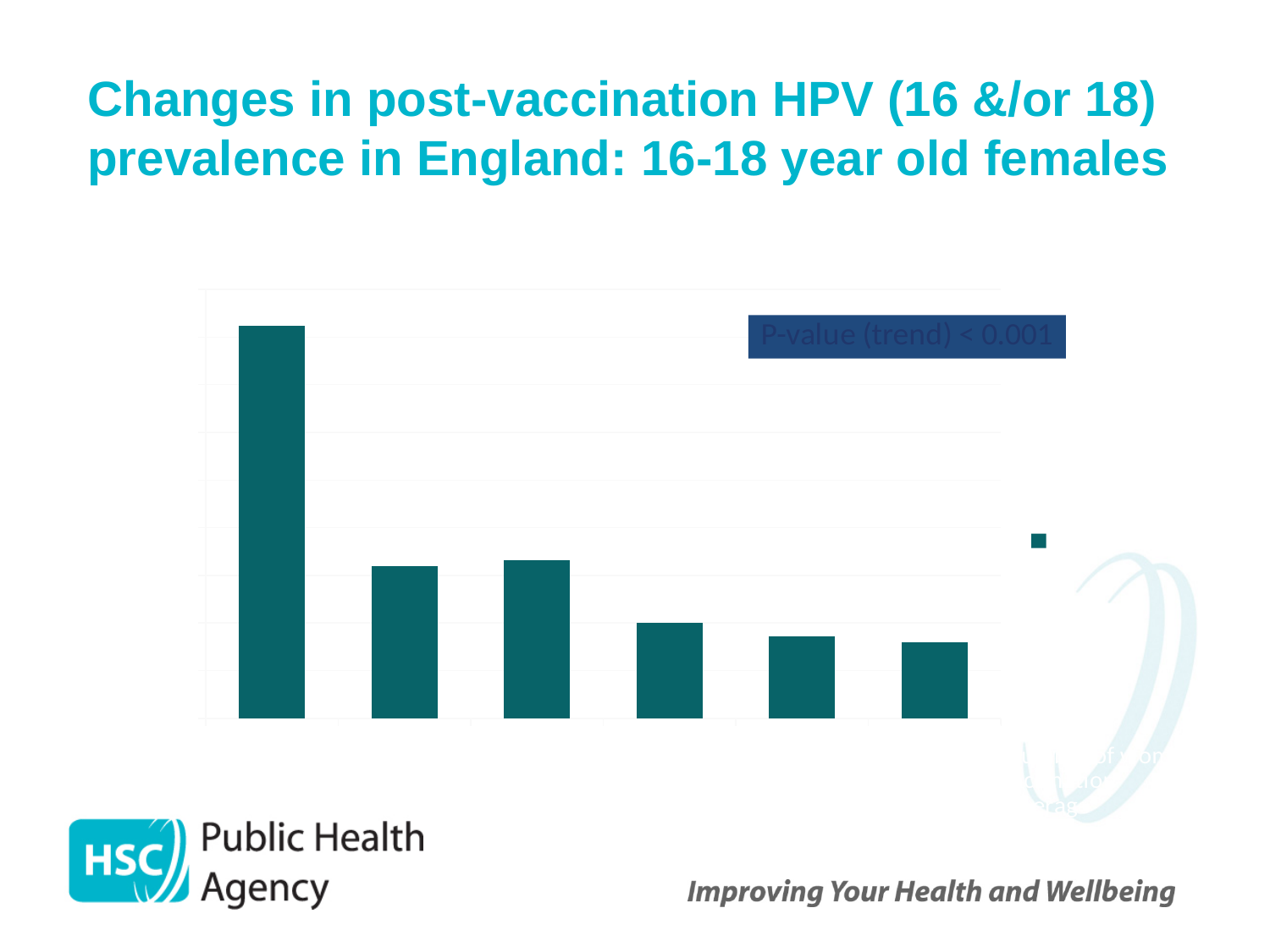
Is the fourth bar taller or shorter than the third bar? shorter Do the bar heights generally rise or fall from left to right across the chart? fall Is the first (leftmost) bar taller or shorter than the second bar? taller What colour are the bars in the chart? teal Which bar in the chart is the tallest? the first (leftmost) bar What P-value for trend is stated in the box on the chart? P-value (trend) < 0.001 Is the first bar taller or shorter than the last (rightmost) bar? taller How many bars are plotted in the chart? 6 What kind of chart is shown on the slide? bar chart